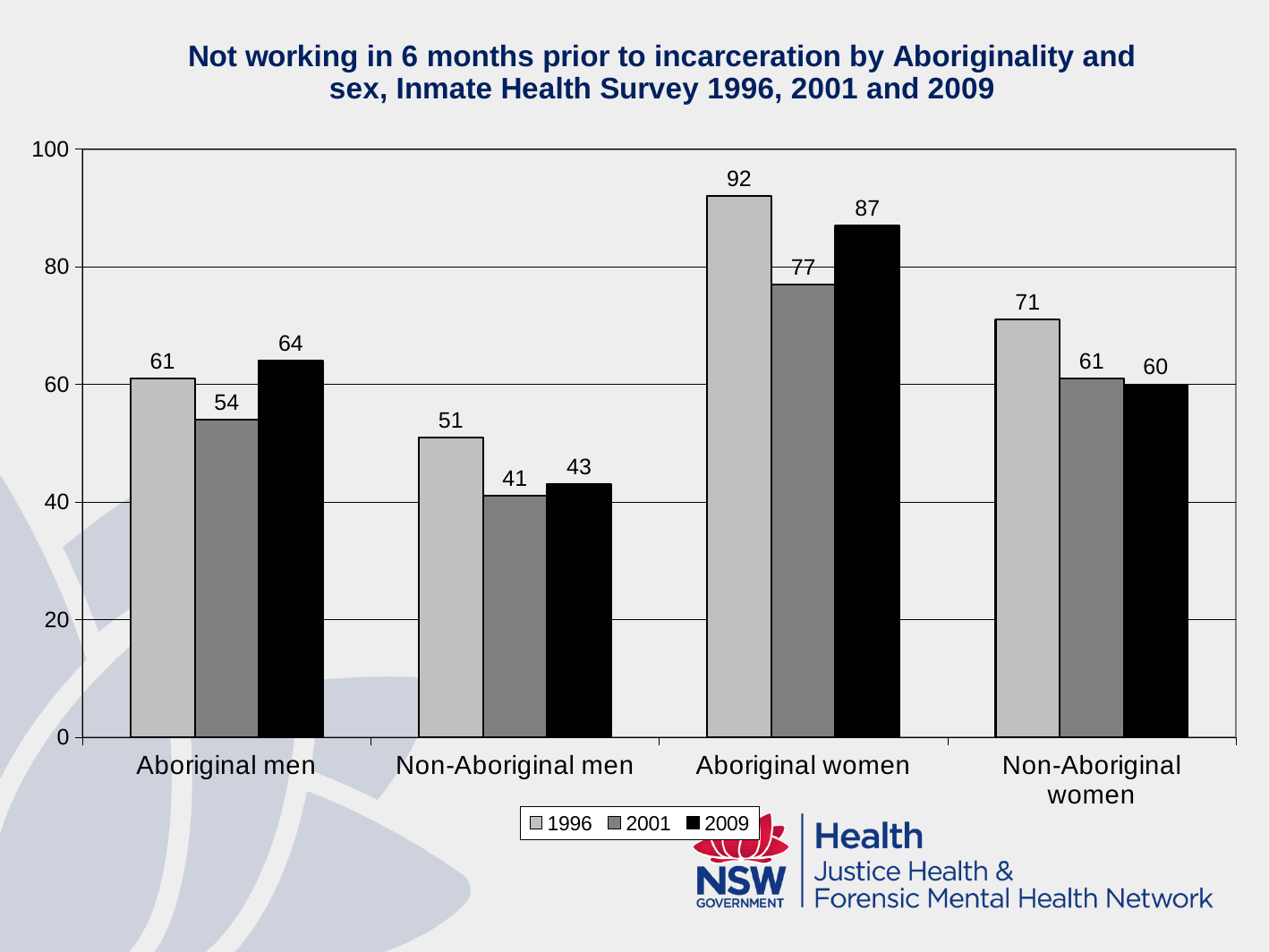
What is the value for Non-Aboriginal women in 2009? 60 Which series is shown in black in the legend? 2009 What kind of chart is shown on the slide? bar chart Which category has the highest value in 2009? Aboriginal women Which category has the lowest value in 2001? Non-Aboriginal men Is the value for Non-Aboriginal women in 1996 greater or less than 60? greater What is the difference between the 1996 and 2001 values for Aboriginal men? 7 Which is larger: the 2009 value for Aboriginal men or the 2009 value for Non-Aboriginal women? Aboriginal men How many categories are shown on the x axis? 4 What is the value for Non-Aboriginal men in 2001? 41 How many series does the legend list? 3 What is the value for Aboriginal women in 1996? 92